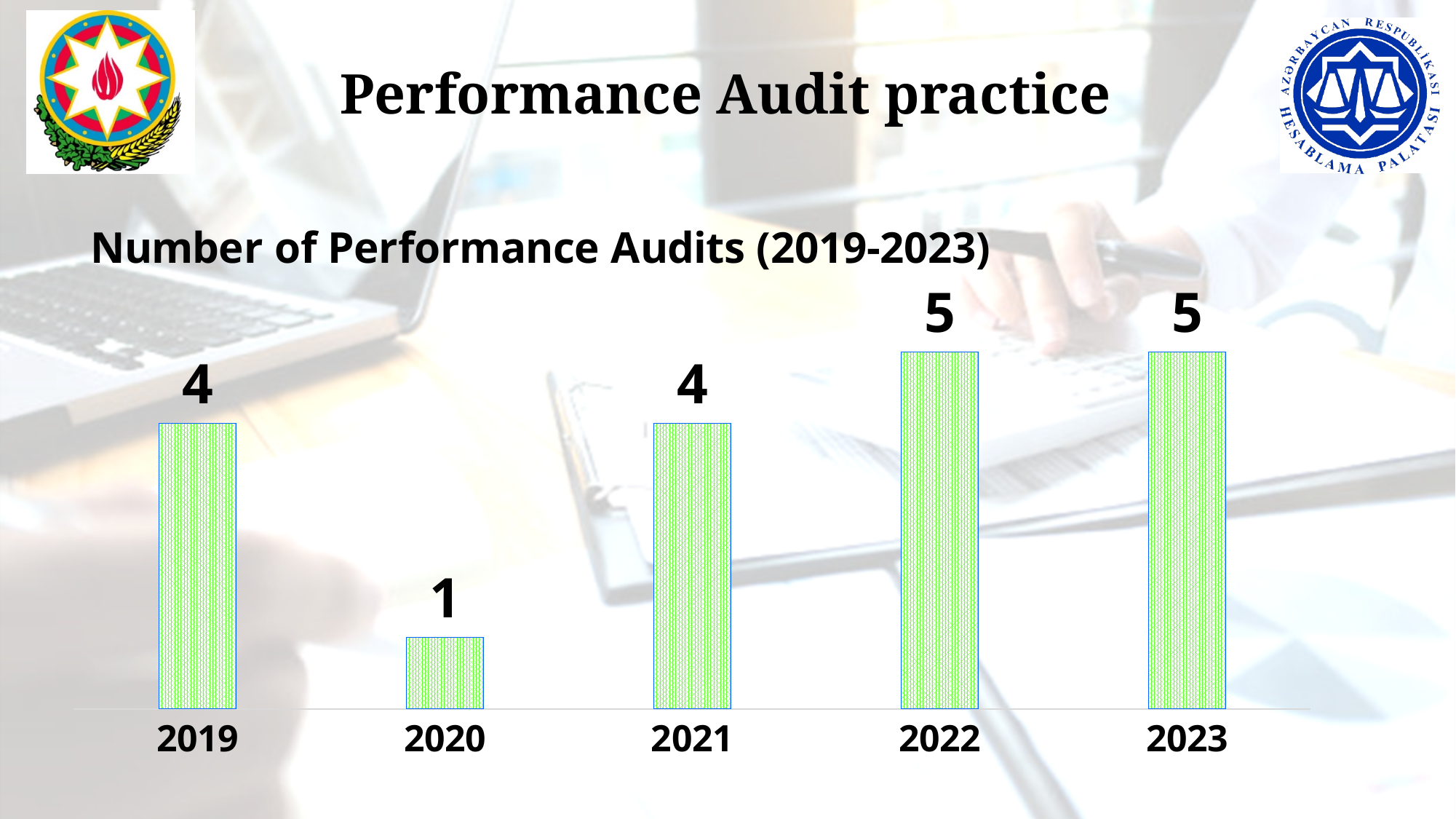
What kind of chart is shown on the slide? bar chart What is the title of the chart? Number of Performance Audits (2019-2023) Which year has the lowest number of performance audits? 2020 What is the number of performance audits shown for 2020? 1 What value is shown for 2022? 5 Which year has more performance audits, 2019 or 2020? 2019 How many performance audits were conducted in 2019? 4 How many years are shown on the chart? 5 What is the difference between the values for 2023 and 2019? 1 What is the difference between the number of audits in 2021 and 2020? 3 Which year has a higher value, 2022 or 2021? 2022 Do the values rise or fall from 2020 to 2022? rise